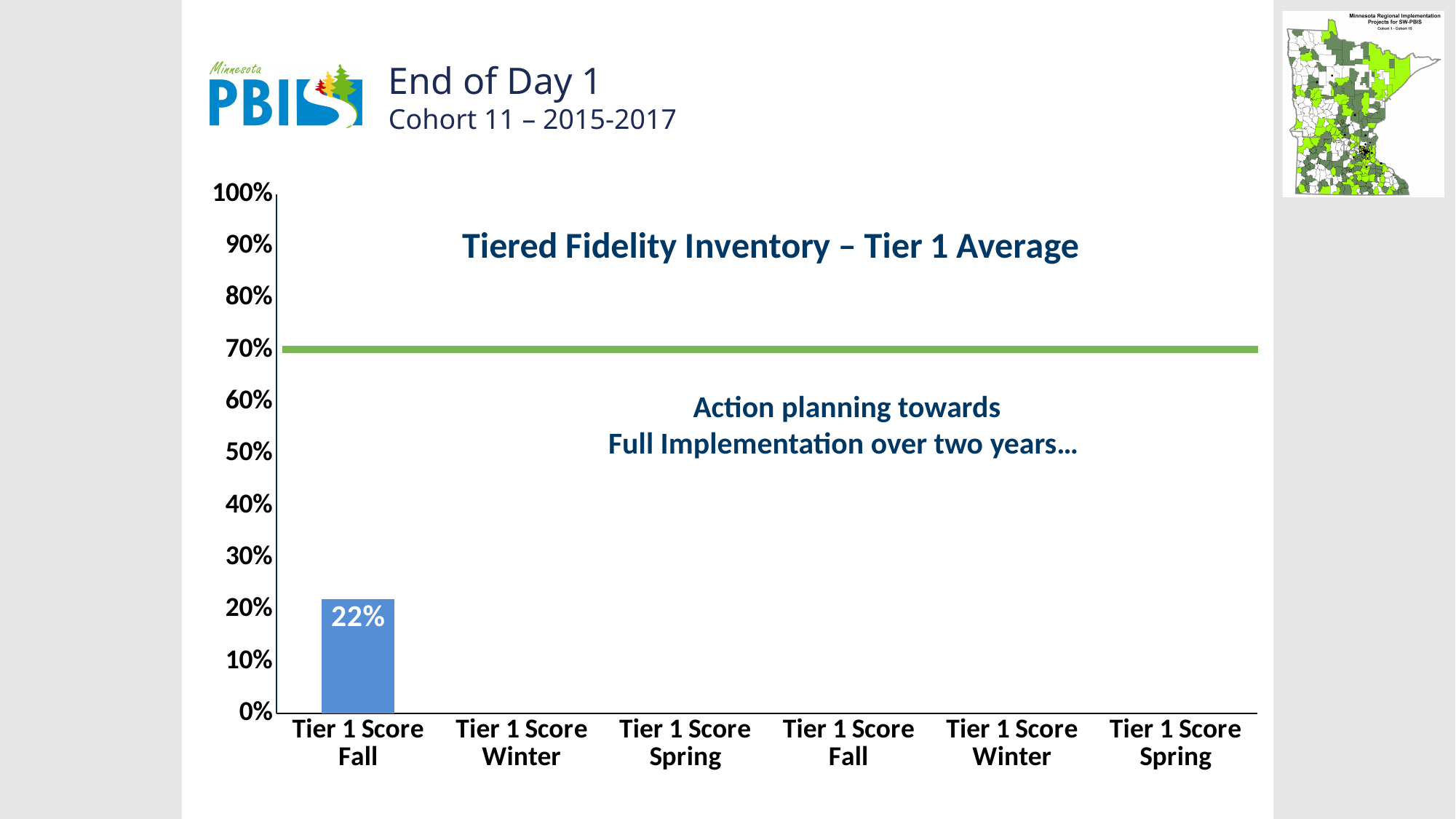
What is the highest value shown on the y axis of the chart? 100% How many bars have a plotted value on the chart? 1 Which is larger, the green line level or the first Tier 1 Score Fall bar? the green line level What is the difference between the green line level and the first Tier 1 Score Fall bar? 48% Is the value for the first Tier 1 Score Fall bar greater or less than 30%? less How many categories are labelled on the x axis of the chart? 6 Is the value for the first Tier 1 Score Fall bar greater or less than 20%? greater At what percentage does the green horizontal line sit on the chart? 70% What is the value of the first Tier 1 Score Fall bar? 22% What is the title of the chart? Tiered Fidelity Inventory – Tier 1 Average Which category has the only plotted bar on the chart? Tier 1 Score Fall (first) What kind of chart is shown on the slide? bar chart